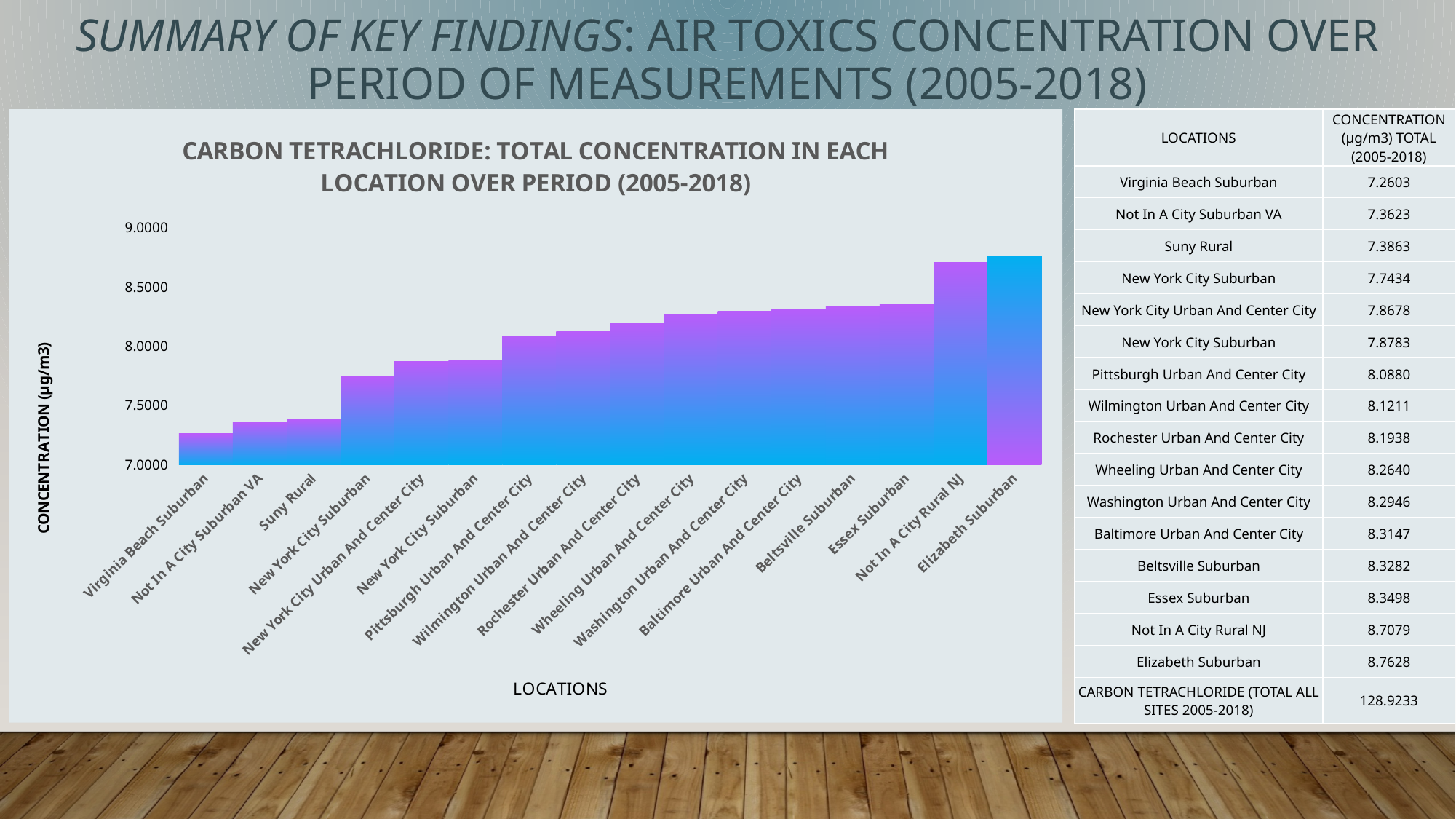
Is the value for Suny Rural greater or less than 7.5000? less What is the total concentration (µg/m3) for Elizabeth Suburban? 8.7628 How many locations are plotted in the bar chart? 16 Which location has the highest carbon tetrachloride concentration in the chart? Elizabeth Suburban Which location has the lowest carbon tetrachloride concentration in the chart? Virginia Beach Suburban Which has a higher concentration, Not In A City Rural NJ or Essex Suburban? Not In A City Rural NJ What is the label on the vertical axis of the chart? CONCENTRATION (µg/m3) What is the total concentration (µg/m3) for Pittsburgh Urban And Center City? 8.0880 What is the difference in concentration between Elizabeth Suburban and Virginia Beach Suburban? 1.5025 Do the bar values rise or fall from left to right along the x axis? Rise What type of chart is shown on the slide? Bar chart What is the total concentration (µg/m3) for Not In A City Rural NJ? 8.7079